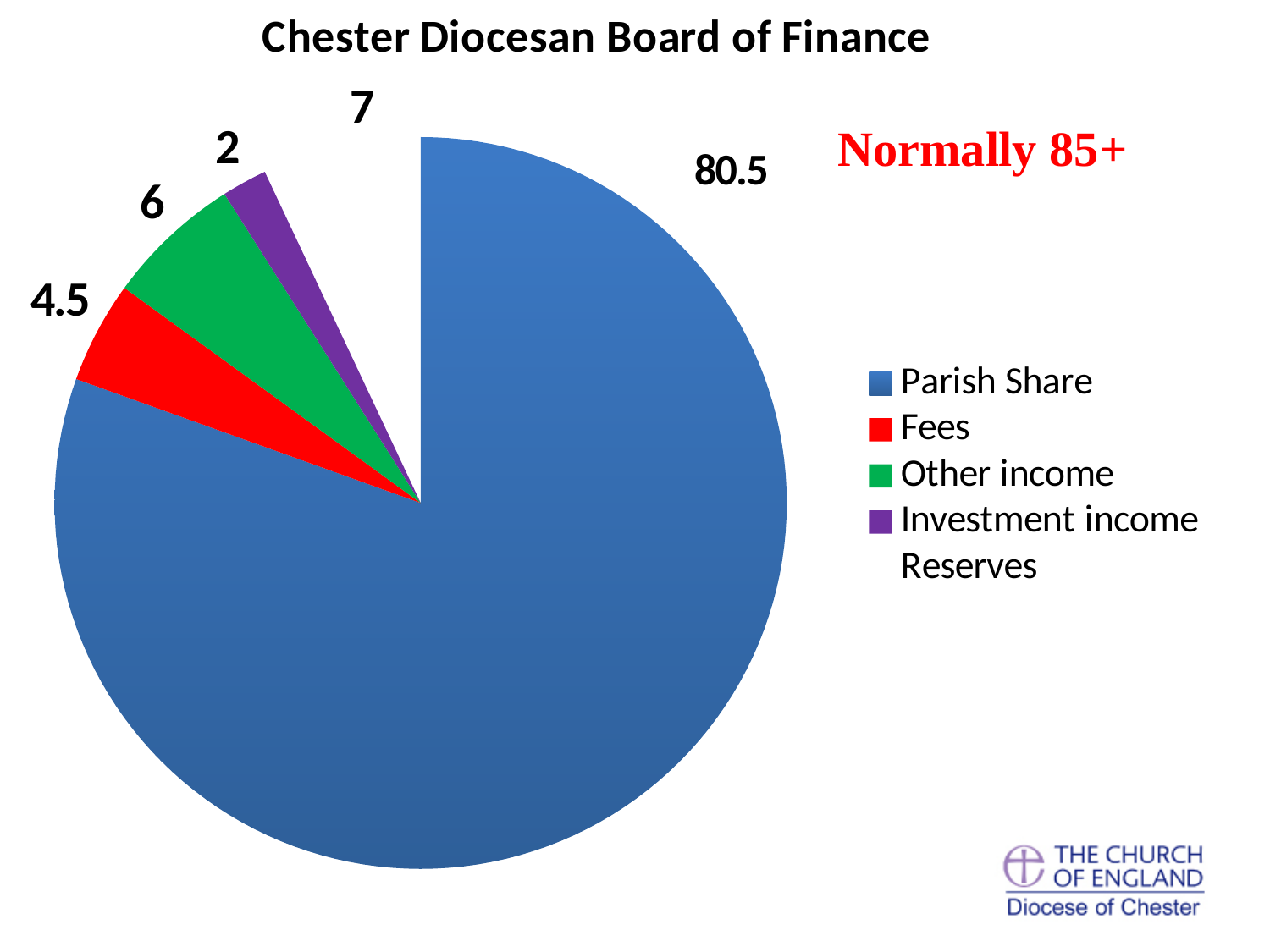
What is the title of the chart? Chester Diocesan Board of Finance What is the value for Reserves? 7 What kind of chart is shown? Pie chart Which category has the smallest slice? Investment income What is the value for Investment income? 2 Which is larger, Fees or Other income? Other income What is the value for Fees? 4.5 How many categories does the legend list? 5 Which category has the largest slice? Parish Share What is the difference between the values for Reserves and Other income? 1 What is the value for Parish Share? 80.5 What is the value for Other income? 6